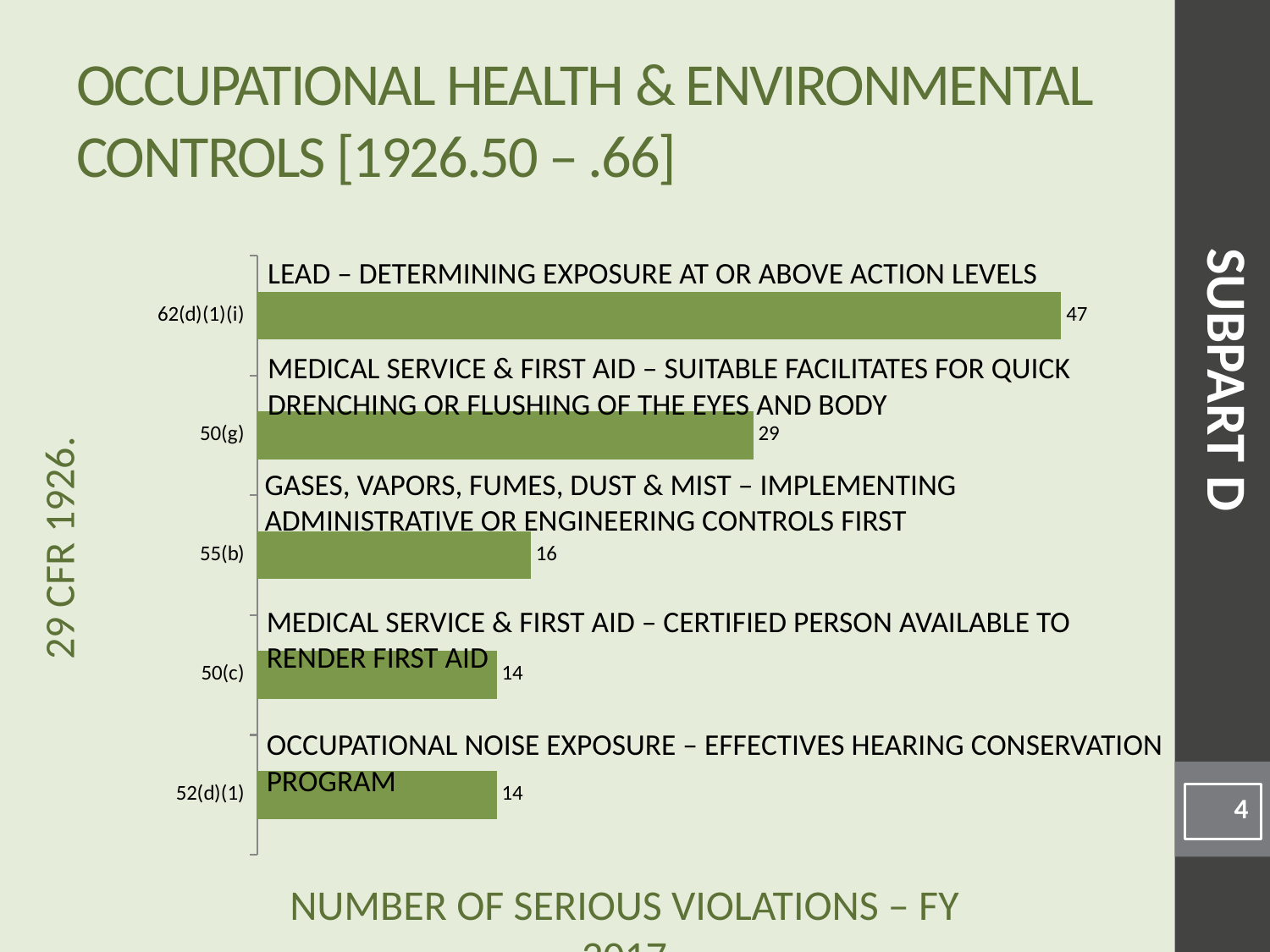
What kind of chart is shown on the slide? Bar chart What is the number of serious violations for 62(d)(1)(i)? 47 Which standard has the highest number of serious violations? 62(d)(1)(i) What is the total number of serious violations across all five standards shown? 120 Which has more serious violations, 50(g) or 55(b)? 50(g) What is the difference in serious violations between 62(d)(1)(i) and 50(g)? 18 What is the difference in serious violations between 50(g) and 55(b)? 13 Which standard is labelled 'LEAD – DETERMINING EXPOSURE AT OR ABOVE ACTION LEVELS'? 62(d)(1)(i) How many standards (bars) are shown in the chart? 5 What is the number of serious violations for 55(b)? 16 What is the number of serious violations for 50(g)? 29 What is the number of serious violations for 52(d)(1)? 14